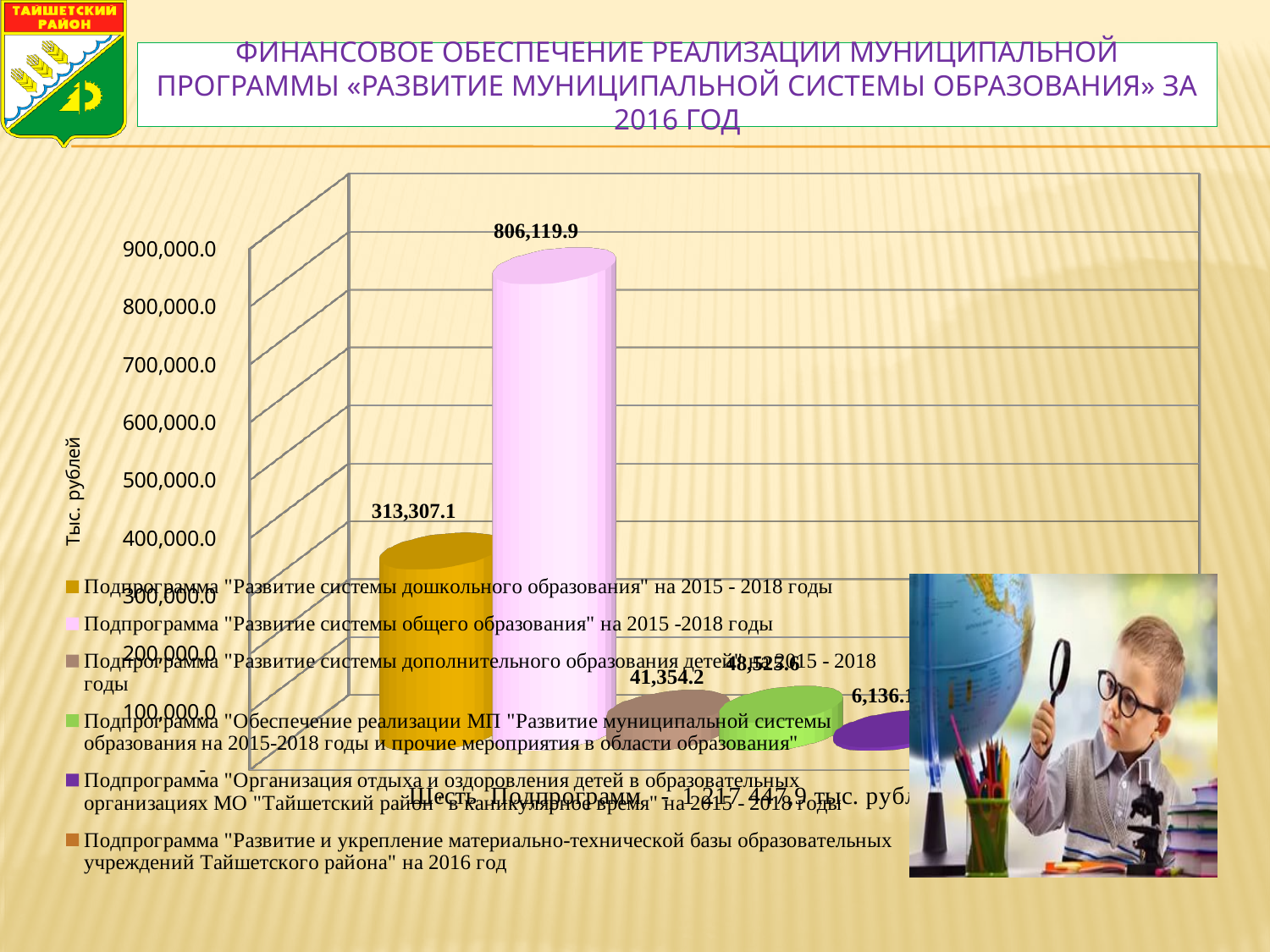
Is the value for the preschool education subprogram (дошкольного образования) greater or less than 300,000.0? greater How many series does the legend list? 6 What is the value for the subprogram "Развитие системы общего образования" на 2015 -2018 годы? 806,119.9 What is the value for the subprogram "Развитие системы дошкольного образования" на 2015 - 2018 годы? 313,307.1 What is the value for the subprogram "Развитие системы дополнительного образования детей"? 41,354.2 What is the difference between the general education subprogram value (806,119.9) and the preschool education subprogram value (313,307.1)? 492,812.8 Which subprogram has the highest value in the chart? Подпрограмма "Развитие системы общего образования" на 2015 -2018 годы What is the value for the subprogram "Обеспечение реализации МП "Развитие муниципальной системы образования на 2015-2018 годы и прочие мероприятия в области образования"? 48,525.6 What is the label on the vertical axis of the chart? Тыс. рублей What kind of chart is shown on the slide? Bar chart Which is larger: the value for the preschool education subprogram (дошкольного образования) or the general education subprogram (общего образования)? Подпрограмма "Развитие системы общего образования"